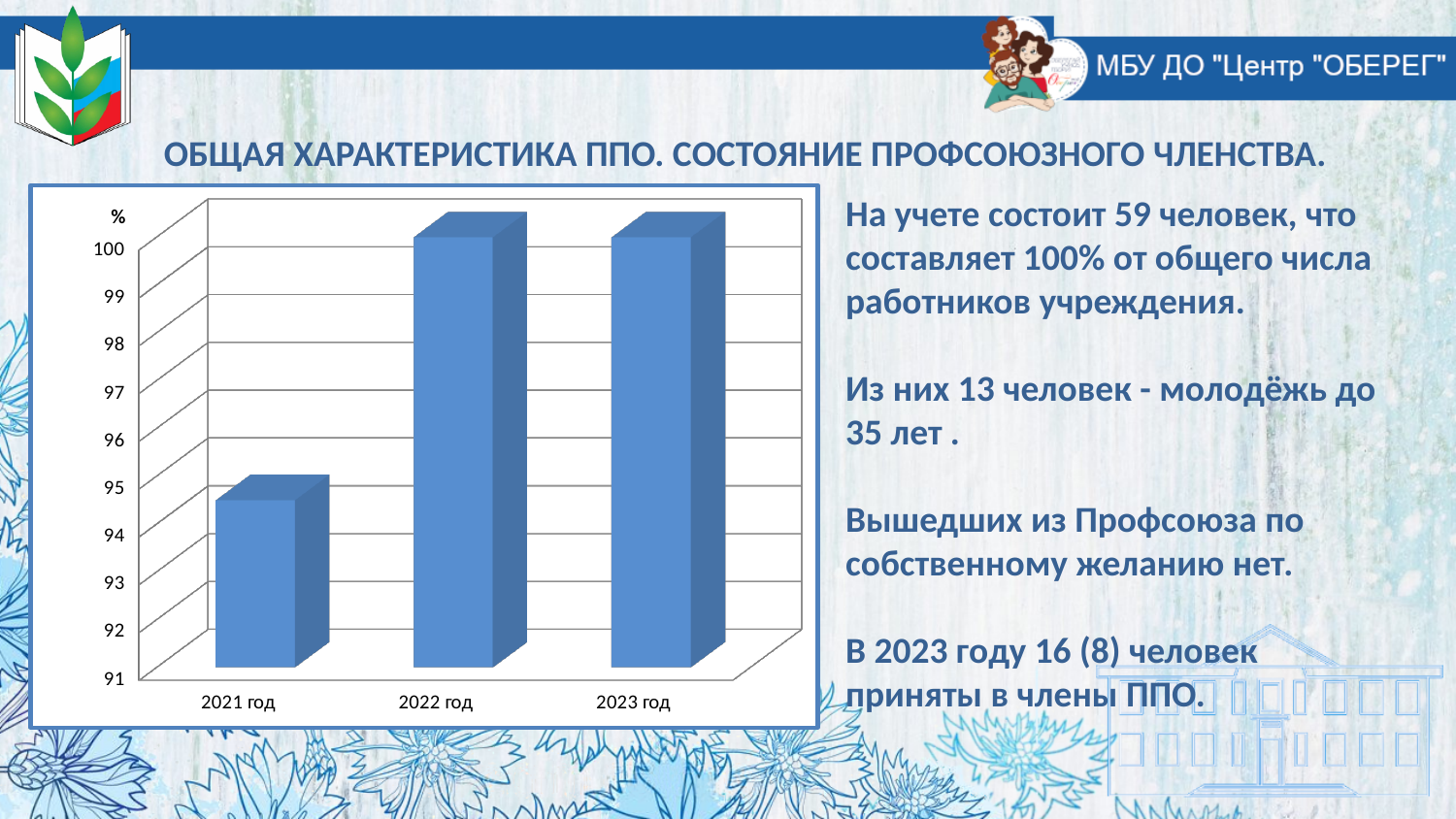
Is the value for 2021 год greater or less than 96? less Which is larger, the value for 2021 год or the value for 2022 год? 2022 год Does the value rise or fall from 2021 год to 2022 год? rise What is the lowest value shown on the vertical axis of the chart? 91 What kind of chart is shown on the slide? bar chart Which year has the lowest bar in the chart? 2021 год Which is larger, the value for 2021 год or the value for 2023 год? 2023 год Is the value for 2023 год greater or less than 97? greater Is the value for 2021 год greater or less than 94? greater What unit label is shown at the top of the vertical axis of the chart? % How many categories (years) are shown on the x axis of the chart? 3